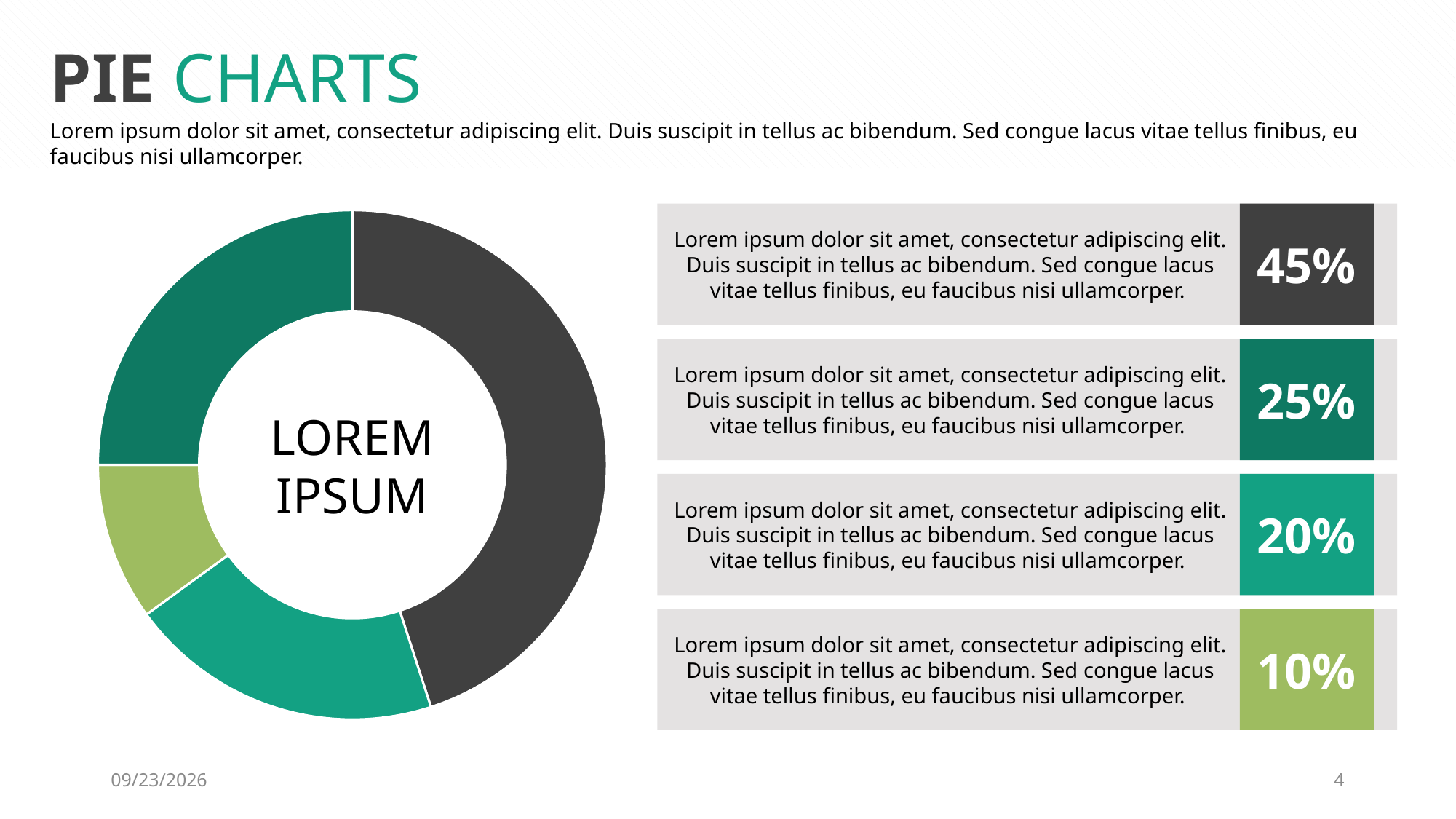
Which is larger, the dark green slice or the teal slice? Dark green What text is written in the centre of the donut chart? LOREM IPSUM Which colour slice is the largest in the pie chart? Dark gray What kind of chart is shown on the slide? Pie chart (donut) What share of the pie does the dark gray slice represent? 45% How many slices does the pie chart have? 4 What percentage is shown for the teal slice of the pie chart? 20% What percentage is shown for the dark gray slice of the pie chart? 45% What percentage is shown for the dark green slice of the pie chart? 25% Which colour slice is the smallest in the pie chart? Light green What is the difference in percentage points between the dark gray slice and the dark green slice? 20 What percentage is shown for the light green slice of the pie chart? 10%